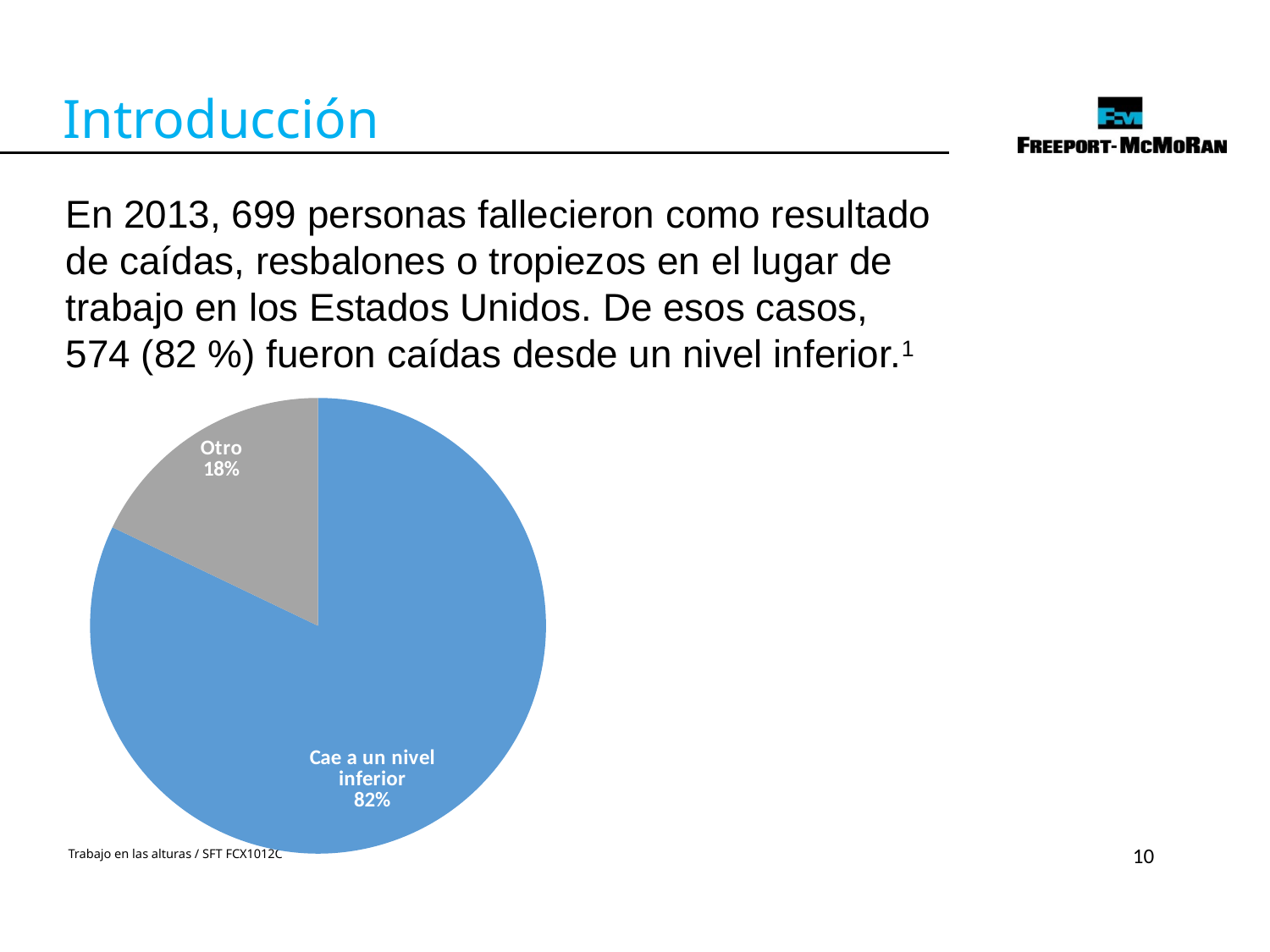
Which slice of the pie is the smallest? Otro What kind of chart is shown on the slide? pie chart Which is larger, the "Otro" slice or the "Cae a un nivel inferior" slice? Cae a un nivel inferior What colour is the "Cae a un nivel inferior" slice? blue What colour is the "Otro" slice? grey What share of the pie does "Otro" represent? 18% How many slices does the pie chart have? 2 What is the difference in percentage points between the "Cae a un nivel inferior" slice and the "Otro" slice? 64 What share of the pie does "Cae a un nivel inferior" represent? 82% Which slice of the pie is the largest? Cae a un nivel inferior